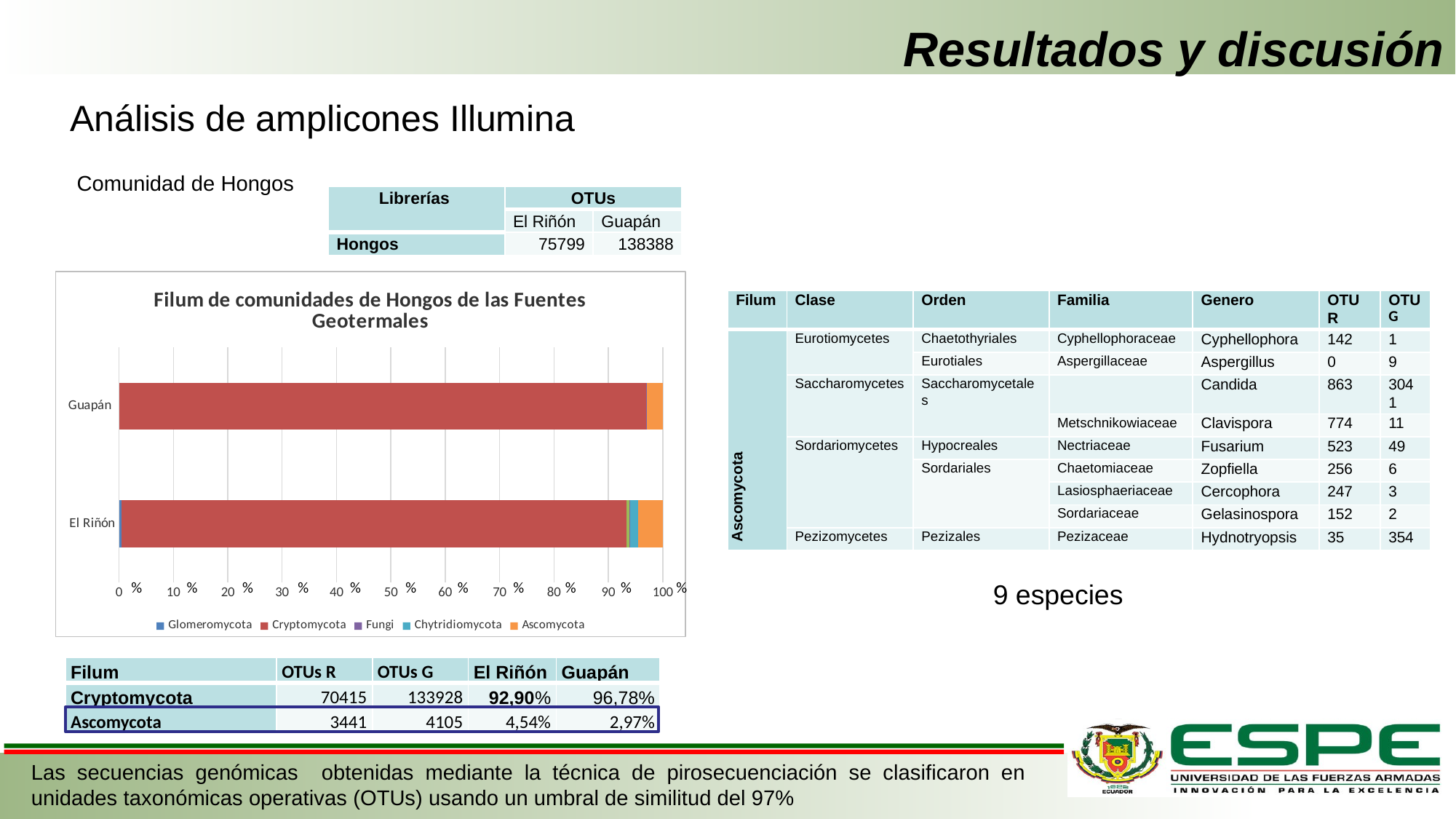
Is the Cryptomycota value for Guapán greater or less than 90 %? greater How many categories (geothermal sources) are plotted on the chart? 2 What is the title of the chart? Filum de comunidades de Hongos de las Fuentes Geotermales Is the Ascomycota value for Guapán greater or less than 10 %? less Which series is shown in orange in the chart legend? Ascomycota Which category has the highest Cryptomycota share? Guapán Which category has the larger Cryptomycota share, Guapán or El Riñón? Guapán Is the Ascomycota value for El Riñón greater or less than 10 %? less How many series does the chart legend list? 5 What kind of chart is shown on the slide? bar chart Which category has the larger Ascomycota share, Guapán or El Riñón? El Riñón